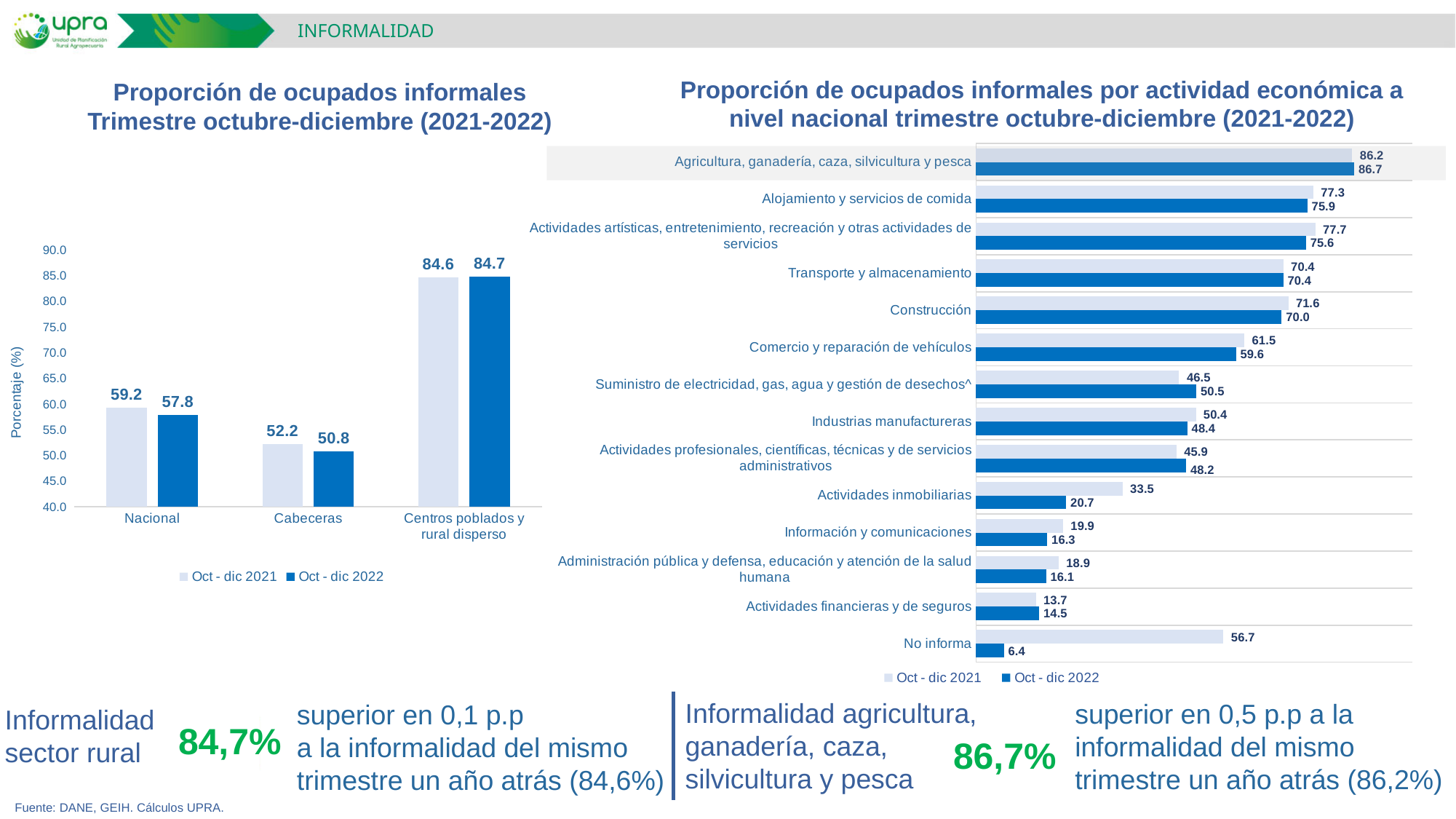
What kind of chart is the right chart 'Proporción de ocupados informales por actividad económica'? Bar chart In the right chart 'Proporción de ocupados informales por actividad económica', which activity has the highest Oct - dic 2022 value? Agricultura, ganadería, caza, silvicultura y pesca In the right chart 'Proporción de ocupados informales por actividad económica', what is the Oct - dic 2021 value for Actividades inmobiliarias? 33.5 In the right chart 'Proporción de ocupados informales por actividad económica', which is larger for Suministro de electricidad, gas, agua y gestión de desechos^: the Oct - dic 2021 value or the Oct - dic 2022 value? Oct - dic 2022 In the left chart 'Proporción de ocupados informales Trimestre octubre-diciembre (2021-2022)', how many series does the legend list? 2 In the right chart 'Proporción de ocupados informales por actividad económica', what is the Oct - dic 2022 value for Construcción? 70.0 In the left chart 'Proporción de ocupados informales Trimestre octubre-diciembre (2021-2022)', what is the difference between the Oct - dic 2021 and Oct - dic 2022 values for Nacional? 1.4 In the left chart 'Proporción de ocupados informales Trimestre octubre-diciembre (2021-2022)', what is the value for Nacional in Oct - dic 2022? 57.8 In the left chart 'Proporción de ocupados informales Trimestre octubre-diciembre (2021-2022)', what is the value for Cabeceras in Oct - dic 2021? 52.2 In the right chart 'Proporción de ocupados informales por actividad económica', which activity has the lowest Oct - dic 2022 value? No informa In the right chart 'Proporción de ocupados informales por actividad económica', how many economic activity categories are shown? 14 In the left chart 'Proporción de ocupados informales Trimestre octubre-diciembre (2021-2022)', which category has the highest value in Oct - dic 2022? Centros poblados y rural disperso